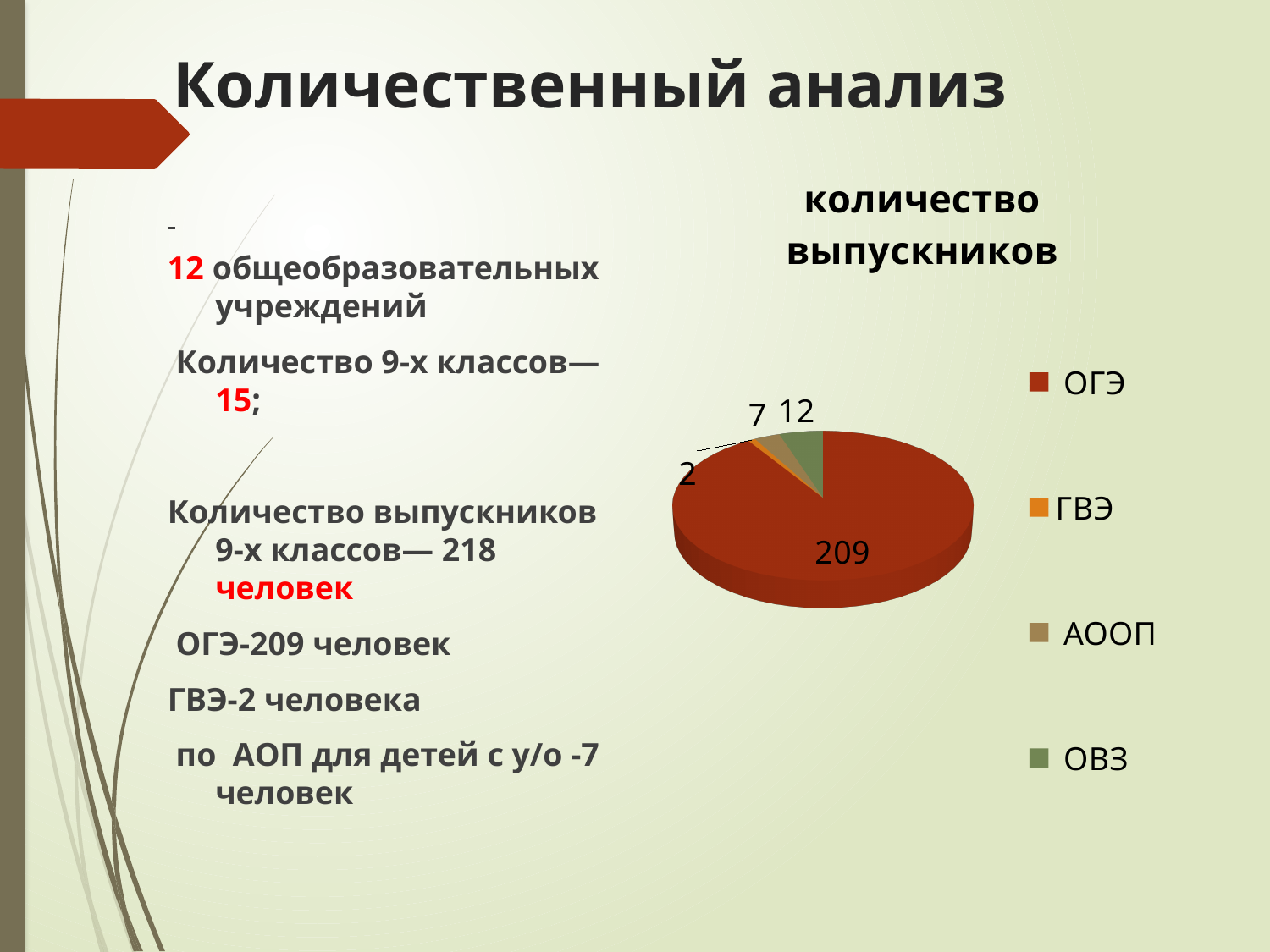
Which category has the smallest slice in the pie chart? ГВЭ What is the value for ОВЗ in the pie chart? 12 What is the value for АООП in the pie chart? 7 Which is larger in the pie chart, ОВЗ or АООП? ОВЗ What type of chart is shown on the slide? pie chart What colour is the ОГЭ slice in the pie chart? red Which category has the largest slice in the pie chart? ОГЭ What is the value for ОГЭ in the pie chart? 209 What is the title of the chart? количество выпускников What is the value for ГВЭ in the pie chart? 2 What is the difference between the values for ОГЭ and ОВЗ in the pie chart? 197 How many categories does the legend of the pie chart list? 4